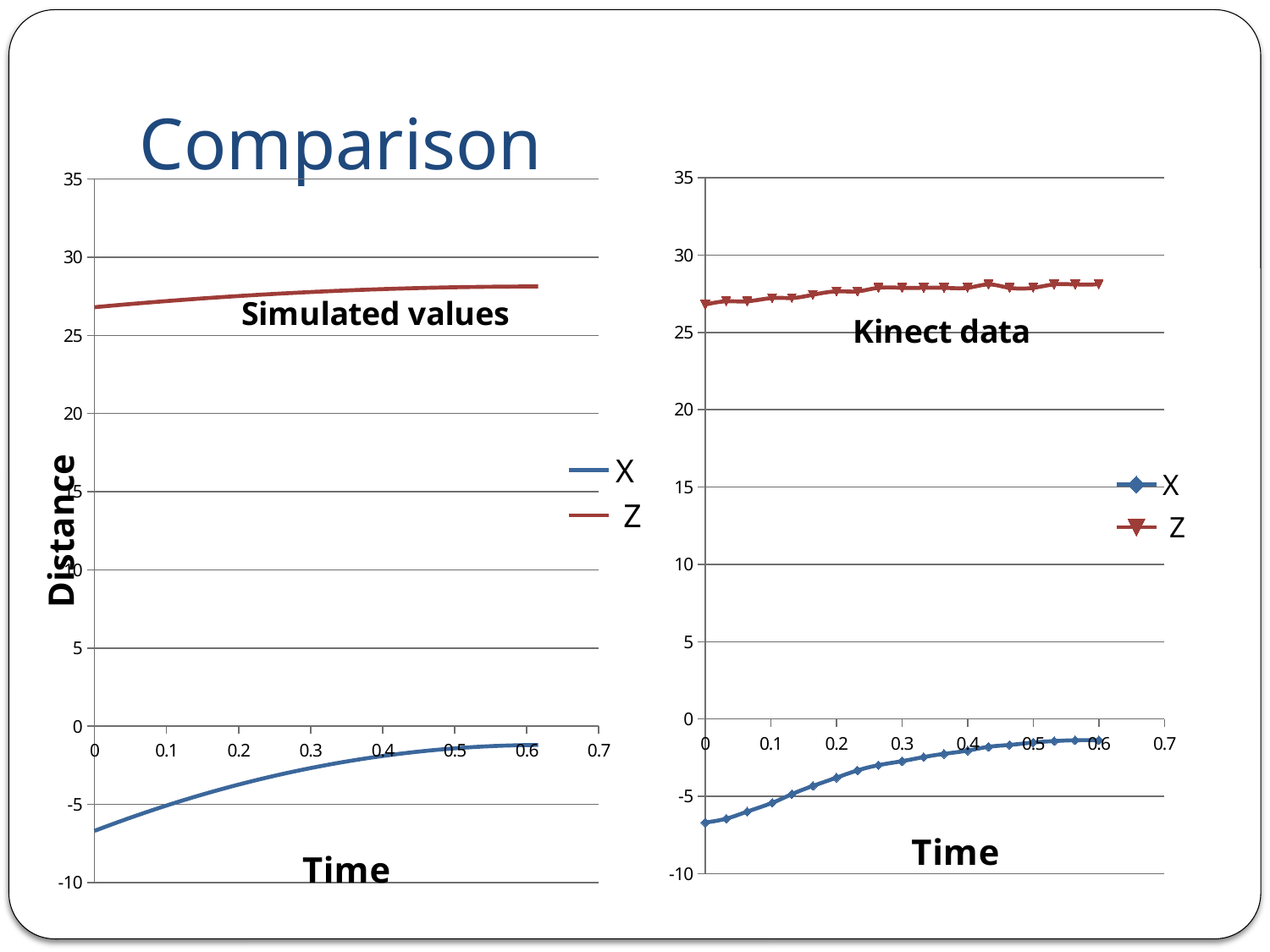
In the 'Kinect data' chart, does the Z series generally rise or fall as time increases? rise How many series does the legend of the 'Simulated values' chart list? 2 What is the label of the horizontal axis on the 'Kinect data' chart? Time What is the label of the vertical axis on the 'Simulated values' chart? Distance In the 'Kinect data' chart, is the value of X at time 0 greater or less than -5? less In the 'Kinect data' chart, which series has higher values, X or Z? Z In the 'Simulated values' chart, is the value of Z at time 0 greater or less than 25? greater What kind of chart is the 'Simulated values' chart on the left? line chart What kind of chart is the 'Kinect data' chart on the right? line chart In the 'Simulated values' chart, does the X series rise or fall as time increases? rise How many series does the legend of the 'Kinect data' chart list? 2 In the 'Simulated values' chart, is the value of X at time 0.6 greater or less than -5? greater